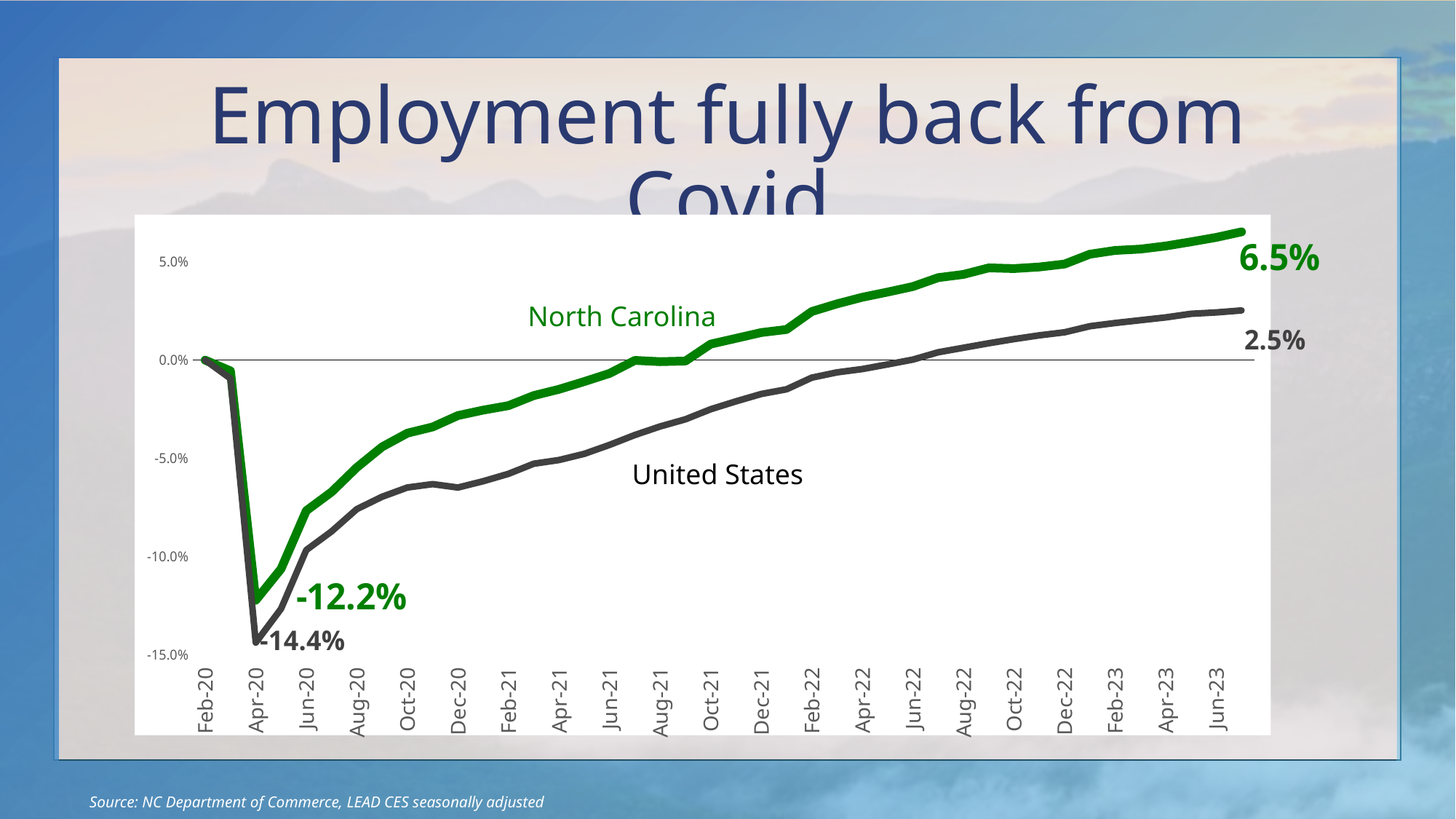
What is the lowest labelled value for North Carolina, at the trough in April 2020? -12.2% What is the difference between the final labelled values for North Carolina (6.5%) and the United States (2.5%)? 4.0% What is the final labelled value for the United States at the right end of the chart? 2.5% What is the final labelled value for North Carolina at the right end of the chart? 6.5% What is the difference between the April 2020 trough values for the United States (-14.4%) and North Carolina (-12.2%)? 2.2% After the April 2020 trough, do the lines generally rise or fall along the x axis? Rise What kind of chart is shown on the slide? Line chart Is the United States value in Dec-20 greater or less than -5.0%? less Which series ends higher at the right end of the chart, North Carolina or the United States? North Carolina Which series fell further at the April 2020 trough, North Carolina or the United States? United States What is the lowest labelled value for the United States, at the trough in April 2020? -14.4% What is the title of the slide containing the chart? Employment fully back from Covid